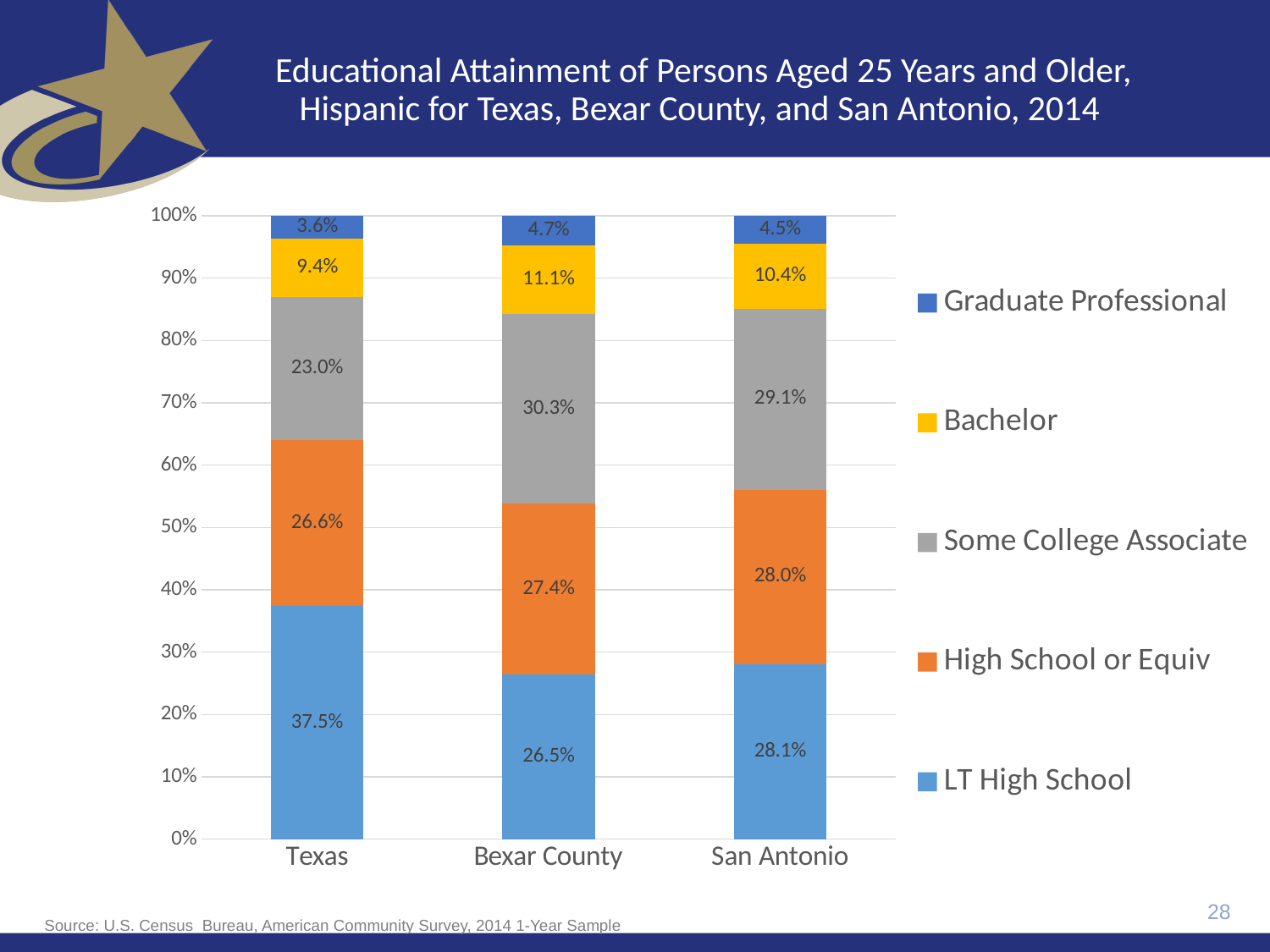
How many areas are shown on the x axis? 3 What is the value for High School or Equiv in San Antonio? 28.0% What is the value for Graduate Professional in San Antonio? 4.5% What is the value for LT High School in Texas? 37.5% How many series does the legend list? 5 Which has a larger Bachelor share, Texas or San Antonio? San Antonio Which area has the highest LT High School share? Texas What is the difference between the Some College Associate values for Bexar County and Texas? 7.3 percentage points What is the value for Bachelor in Bexar County? 11.1% Which legend entry is listed first at the top of the legend? Graduate Professional Which area has the lowest Graduate Professional share? Texas What kind of chart is shown? Stacked bar chart